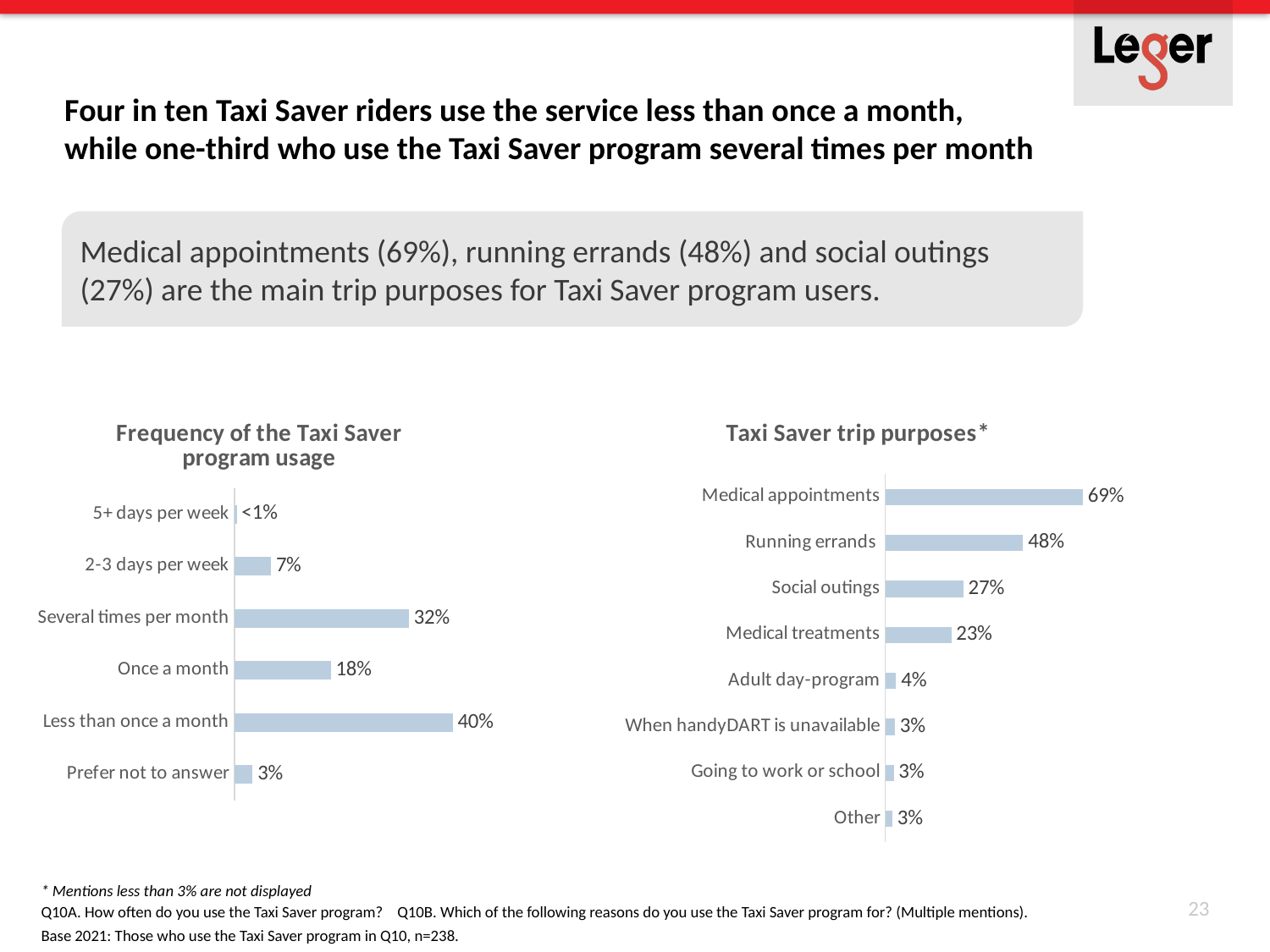
In the 'Taxi Saver trip purposes*' chart, which category has the highest value? Medical appointments In the 'Frequency of the Taxi Saver program usage' chart, which category has the highest value? Less than once a month In the 'Frequency of the Taxi Saver program usage' chart, what is the difference between 'Less than once a month' and 'Once a month'? 22 percentage points In the 'Frequency of the Taxi Saver program usage' chart, how many categories are shown? 6 In the 'Taxi Saver trip purposes*' chart, what is the difference between 'Medical appointments' and 'Running errands'? 21 percentage points In the 'Taxi Saver trip purposes*' chart, how many categories are shown? 8 In the 'Frequency of the Taxi Saver program usage' chart, which is larger: '2-3 days per week' or 'Prefer not to answer'? 2-3 days per week In the 'Frequency of the Taxi Saver program usage' chart, what is the value for 'Several times per month'? 32% In the 'Taxi Saver trip purposes*' chart, which is larger: 'Running errands' or 'Social outings'? Running errands In the 'Taxi Saver trip purposes*' chart, what is the value for 'Medical treatments'? 23% In the 'Frequency of the Taxi Saver program usage' chart, what is the value for '5+ days per week'? <1% What type of chart is the 'Taxi Saver trip purposes*' chart? Bar chart